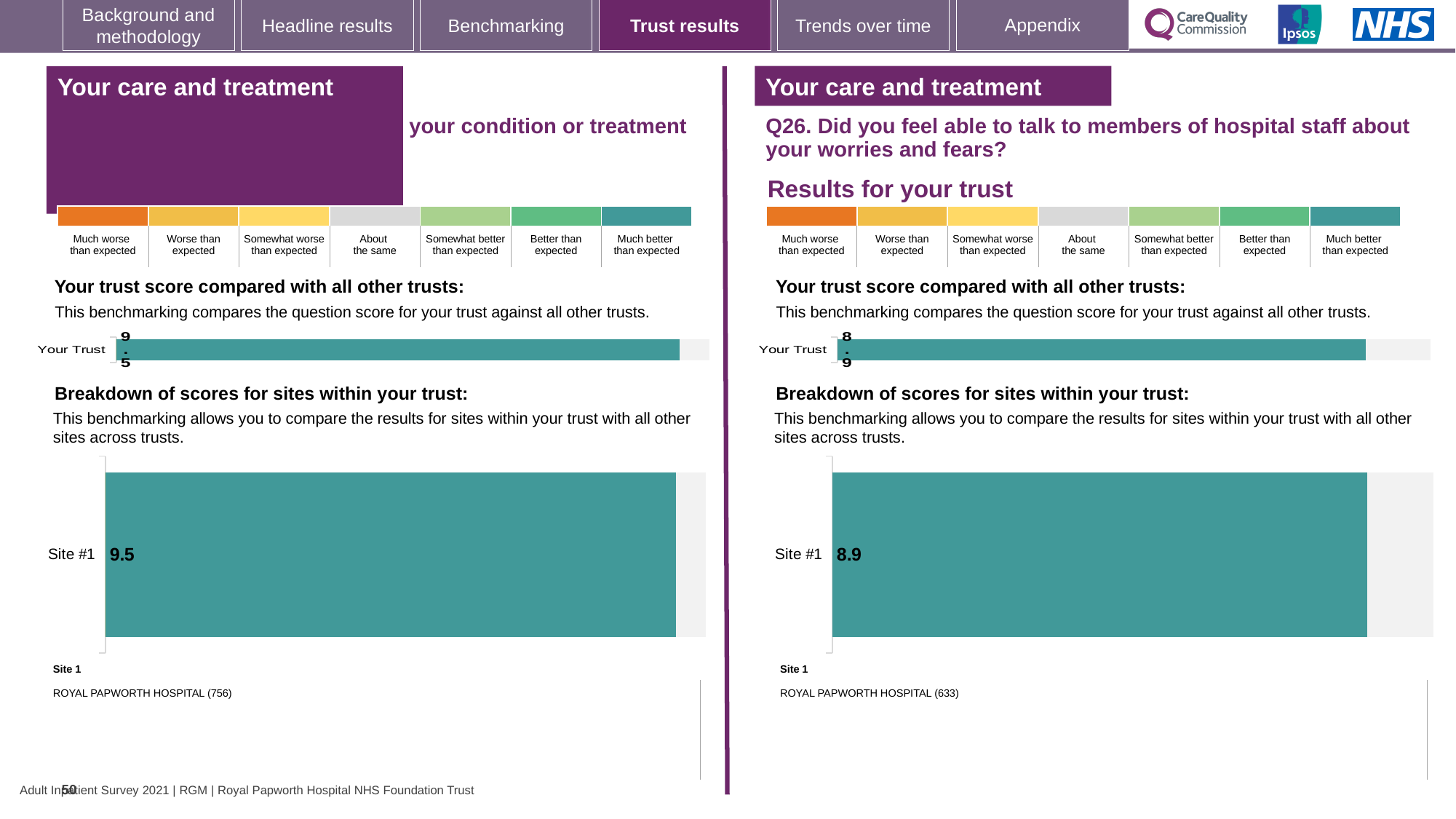
On the left half of the slide, what is the name of Site 1 listed below the chart? ROYAL PAPWORTH HOSPITAL (756) On the right half of the slide (Q26), what is the name of Site 1 listed below the chart? ROYAL PAPWORTH HOSPITAL (633) On the right half of the slide (Q26), is the Site #1 score greater or less than the Your Trust score, or are they equal? Equal On the left half of the slide, what is the score shown for Site #1 in the 'Breakdown of scores for sites within your trust' chart? 9.5 How many sites are shown in the 'Breakdown of scores for sites within your trust' chart on the left half of the slide? 1 On the left half of the slide, what is the value shown for Your Trust in the 'Your trust score compared with all other trusts' chart? 9.5 On the right half of the slide (Q26), what is the score shown for Site #1 in the 'Breakdown of scores for sites within your trust' chart? 8.9 Which is larger: the Site #1 score on the left half of the slide or the Site #1 score on the right half (Q26)? Left half (9.5) How many sites are shown in the 'Breakdown of scores for sites within your trust' chart on the right half of the slide (Q26)? 1 What is the difference between the Your Trust score on the left half of the slide and the Your Trust score on the right half (Q26)? 0.6 On the right half of the slide (Q26), what is the value shown for Your Trust in the 'Your trust score compared with all other trusts' chart? 8.9 What kind of chart is used to show the Site #1 score on the right half of the slide (Q26)? Bar chart